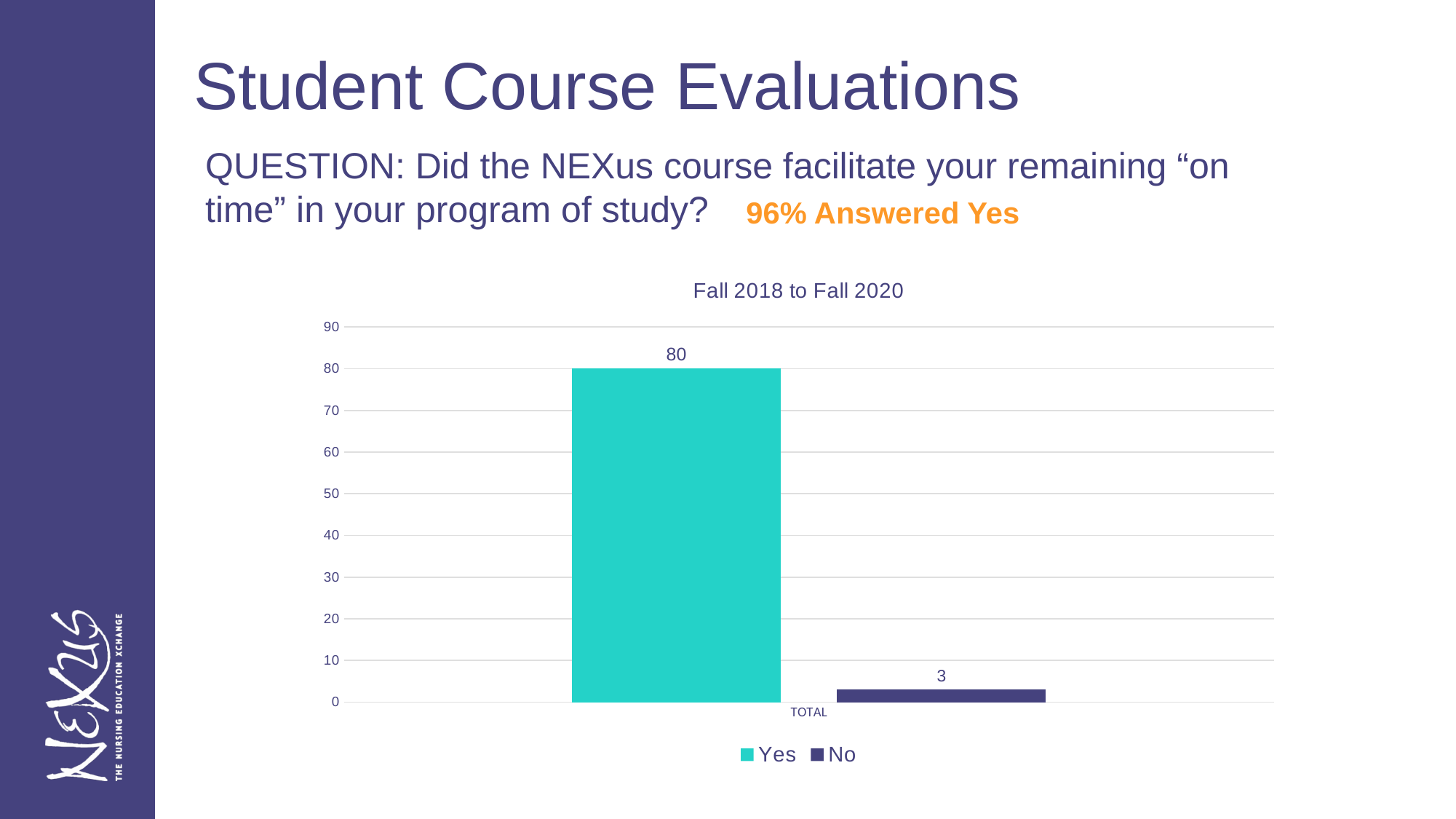
Which series has the higher value, Yes or No? Yes What is the difference between the Yes and No values? 77 Is the value for No greater or less than 10? less What kind of chart is shown on the slide? Bar chart How many series does the legend list? 2 What is the title of the chart? Fall 2018 to Fall 2020 What is the value of the Yes bar in the chart? 80 Which series has the lowest value in the chart? No What is the combined total of the Yes and No values? 83 Is the value for Yes greater or less than 70? greater What is the value of the No bar in the chart? 3 What is the label on the x axis category? TOTAL